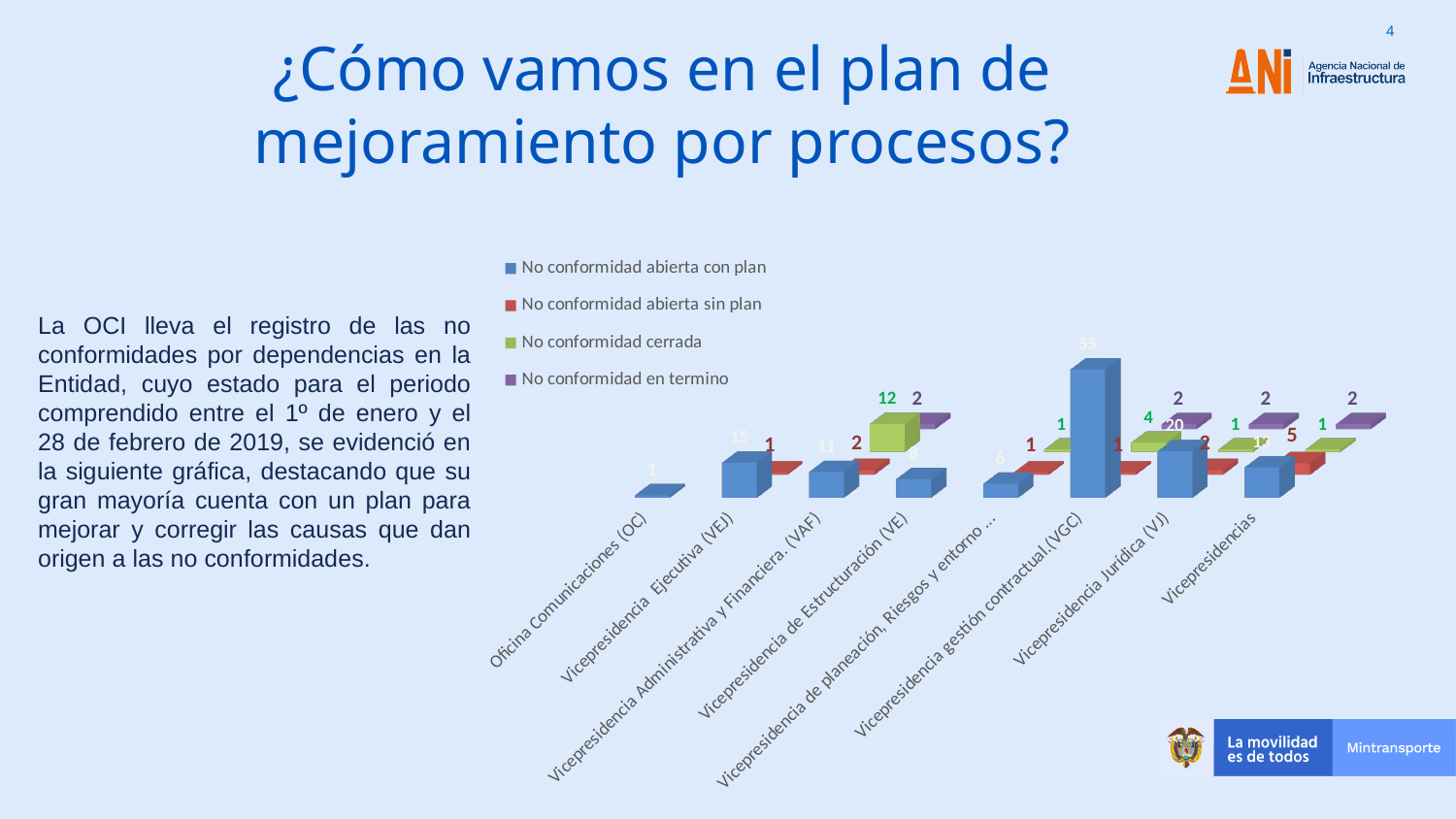
What is the value of 'No conformidad abierta con plan' for Vicepresidencia gestión contractual (VGC)? 55 Which colour represents 'No conformidad cerrada' in the chart legend? green What is the difference between the 'No conformidad abierta con plan' values for Vicepresidencia gestión contractual (VGC) and Vicepresidencia Jurídica (VJ)? 35 Which dependency has the highest value for 'No conformidad abierta con plan'? Vicepresidencia gestión contractual (VGC) What is the value of 'No conformidad abierta con plan' for Vicepresidencia Jurídica (VJ)? 20 What is the value of 'No conformidad abierta con plan' for Vicepresidencia Ejecutiva (VEJ)? 15 How many dependencies (categories) are shown on the x axis of the chart? 8 What kind of chart is shown on the slide? bar chart What is the value of 'No conformidad abierta sin plan' for Vicepresidencias? 5 How many series does the chart legend list? 4 Which has a larger 'No conformidad abierta con plan' value: Vicepresidencia Ejecutiva (VEJ) or Vicepresidencia Administrativa y Financiera (VAF)? Vicepresidencia Ejecutiva (VEJ)